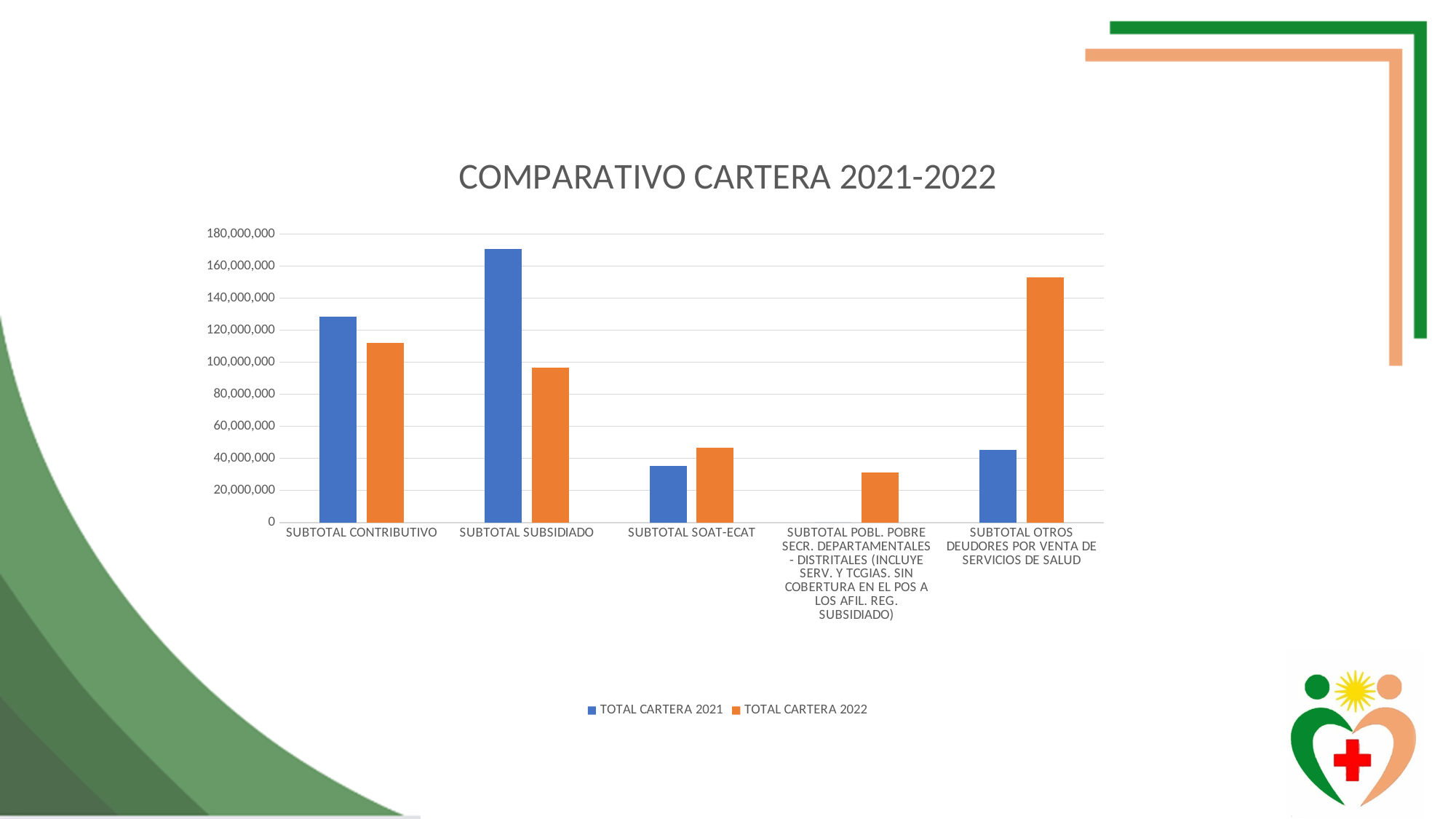
Which category has the lowest value for TOTAL CARTERA 2022? SUBTOTAL POBL. POBRE SECR. DEPARTAMENTALES - DISTRITALES Which category has the highest value for TOTAL CARTERA 2022? SUBTOTAL OTROS DEUDORES POR VENTA DE SERVICIOS DE SALUD Is the TOTAL CARTERA 2022 value for SUBTOTAL OTROS DEUDORES POR VENTA DE SERVICIOS DE SALUD greater or less than 140,000,000? greater How many series does the legend list? 2 For SUBTOTAL CONTRIBUTIVO, which is larger: TOTAL CARTERA 2021 or TOTAL CARTERA 2022? TOTAL CARTERA 2021 What kind of chart is shown on the slide? Bar chart Which category has the highest value for TOTAL CARTERA 2021? SUBTOTAL SUBSIDIADO What is the title of the chart? COMPARATIVO CARTERA 2021-2022 Is the TOTAL CARTERA 2021 value for SUBTOTAL SUBSIDIADO greater or less than 160,000,000? greater Is the TOTAL CARTERA 2022 value for SUBTOTAL POBL. POBRE SECR. DEPARTAMENTALES - DISTRITALES greater or less than 40,000,000? less For SUBTOTAL SOAT-ECAT, which is larger: TOTAL CARTERA 2021 or TOTAL CARTERA 2022? TOTAL CARTERA 2022 How many categories are shown on the x axis? 5